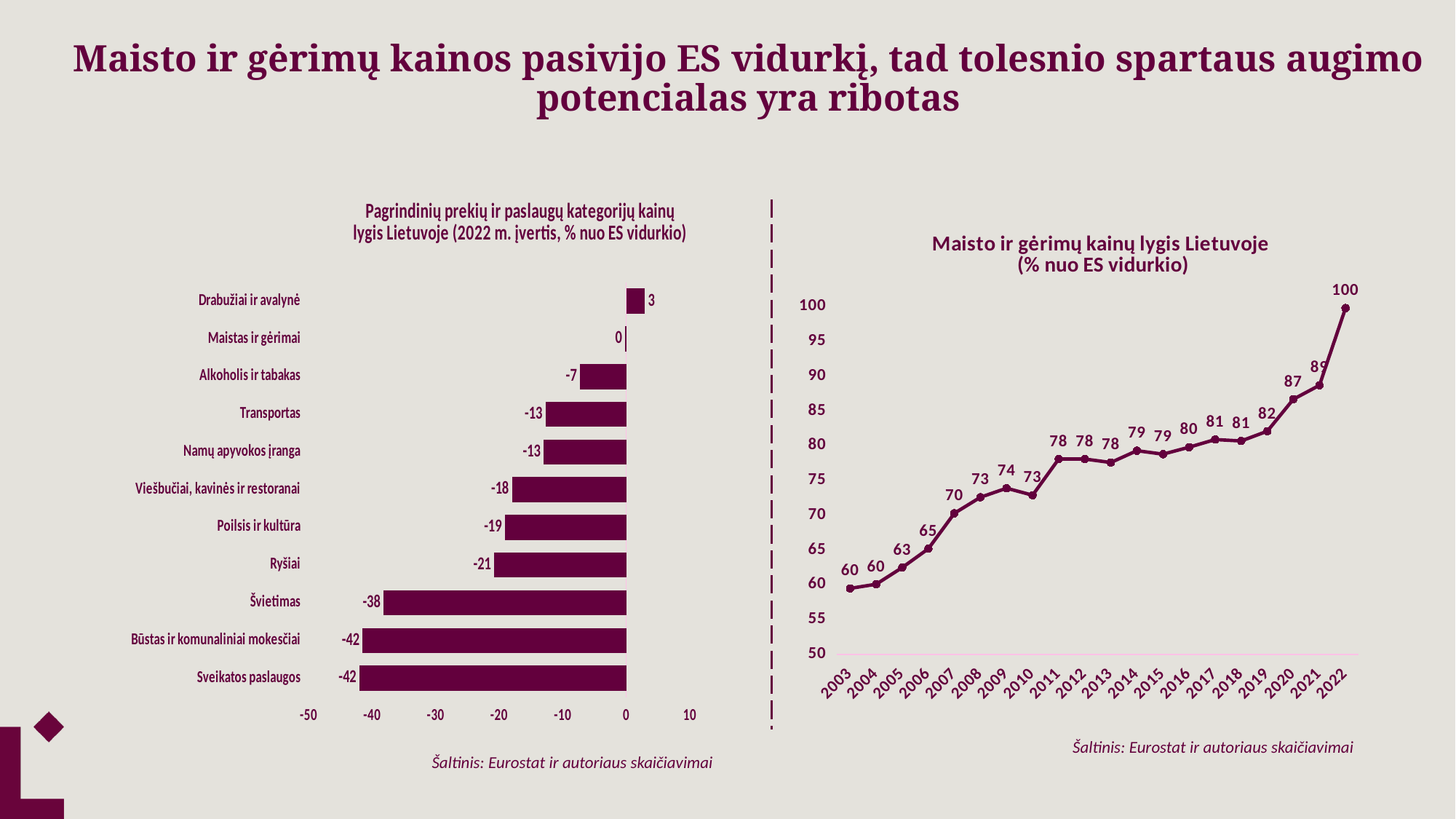
In the left bar chart, what is the value for Ryšiai? -21 In the left bar chart, what is the value for Švietimas? -38 What kind of chart is the chart on the left of the slide? Bar chart In the left bar chart, what is the difference between the values for Alkoholis ir tabakas and Viešbučiai, kavinės ir restoranai? 11 In the left bar chart, which category has the highest value? Drabužiai ir avalynė In the right chart 'Maisto ir gėrimų kainų lygis Lietuvoje', what is the value for 2007? 70 In the right chart 'Maisto ir gėrimų kainų lygis Lietuvoje', do the values generally rise or fall from 2003 to 2022? Rise In the right chart 'Maisto ir gėrimų kainų lygis Lietuvoje', which year has the highest value? 2022 What kind of chart is the chart on the right of the slide? Line chart How many categories does the left bar chart show? 11 In the right chart 'Maisto ir gėrimų kainų lygis Lietuvoje', what is the difference between the values for 2022 and 2020? 13 In the left bar chart, which is larger: the value for Transportas or the value for Poilsis ir kultūra? Transportas